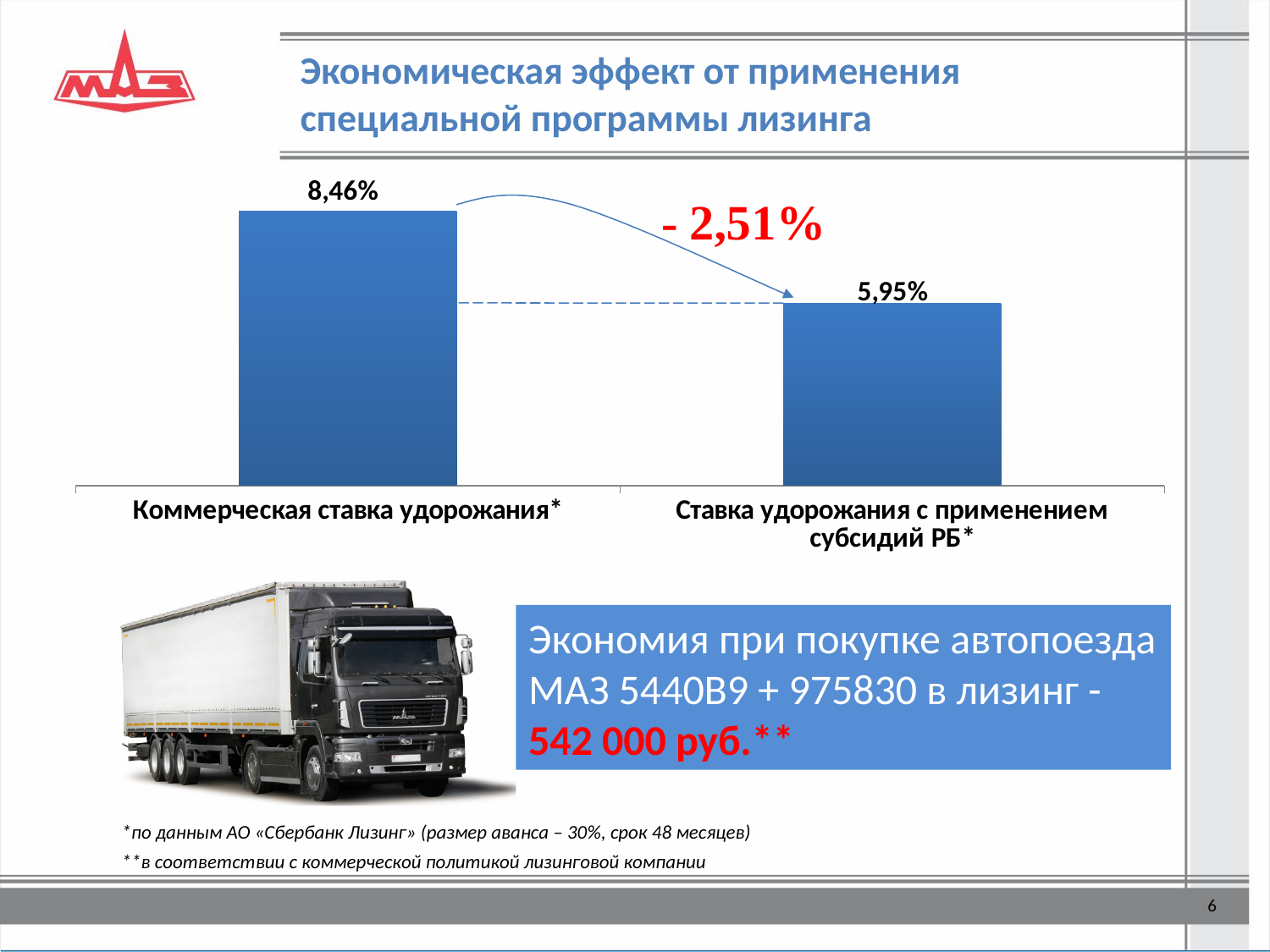
Which is larger: «Коммерческая ставка удорожания*» or «Ставка удорожания с применением субсидий РБ*»? Коммерческая ставка удорожания* What colour are the bars in the chart? Blue Which category has the highest value? Коммерческая ставка удорожания* How many categories are shown in the chart? 2 Do the values rise or fall from left to right across the chart? Fall What is the value for «Ставка удорожания с применением субсидий РБ*»? 5,95% Which category has the lowest value? Ставка удорожания с применением субсидий РБ* What is the difference between «Коммерческая ставка удорожания*» and «Ставка удорожания с применением субсидий РБ*»? 2,51% What reduction is shown in red above the arrow between the two bars? - 2,51% What is the value for «Коммерческая ставка удорожания*»? 8,46% What kind of chart is shown on the slide? Bar chart